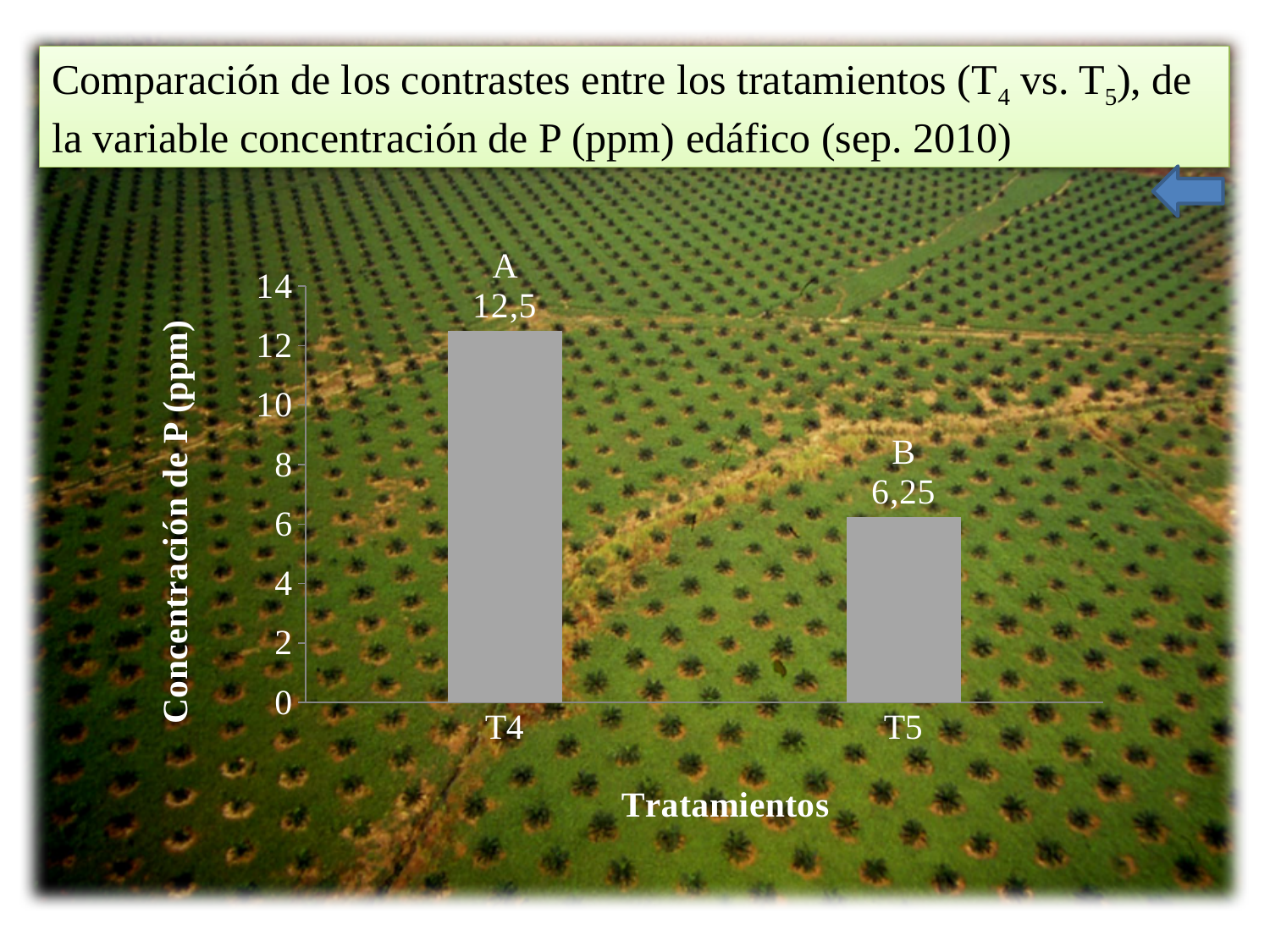
What is the P concentration value for treatment T4? 12,5 What is the difference between the P concentration values for T4 and T5? 6,25 Is the value for T5 greater or less than 8? less What is the label of the y axis? Concentración de P (ppm) Is the value for T4 greater or less than 10? greater What kind of chart is shown on the slide? bar chart Which treatment has a larger P concentration, T4 or T5? T4 What is the P concentration value for treatment T5? 6,25 What letter is printed above the bar for T5? B Which treatment has the highest P concentration? T4 Which treatment has the lowest P concentration? T5 How many treatments are shown on the x axis? 2